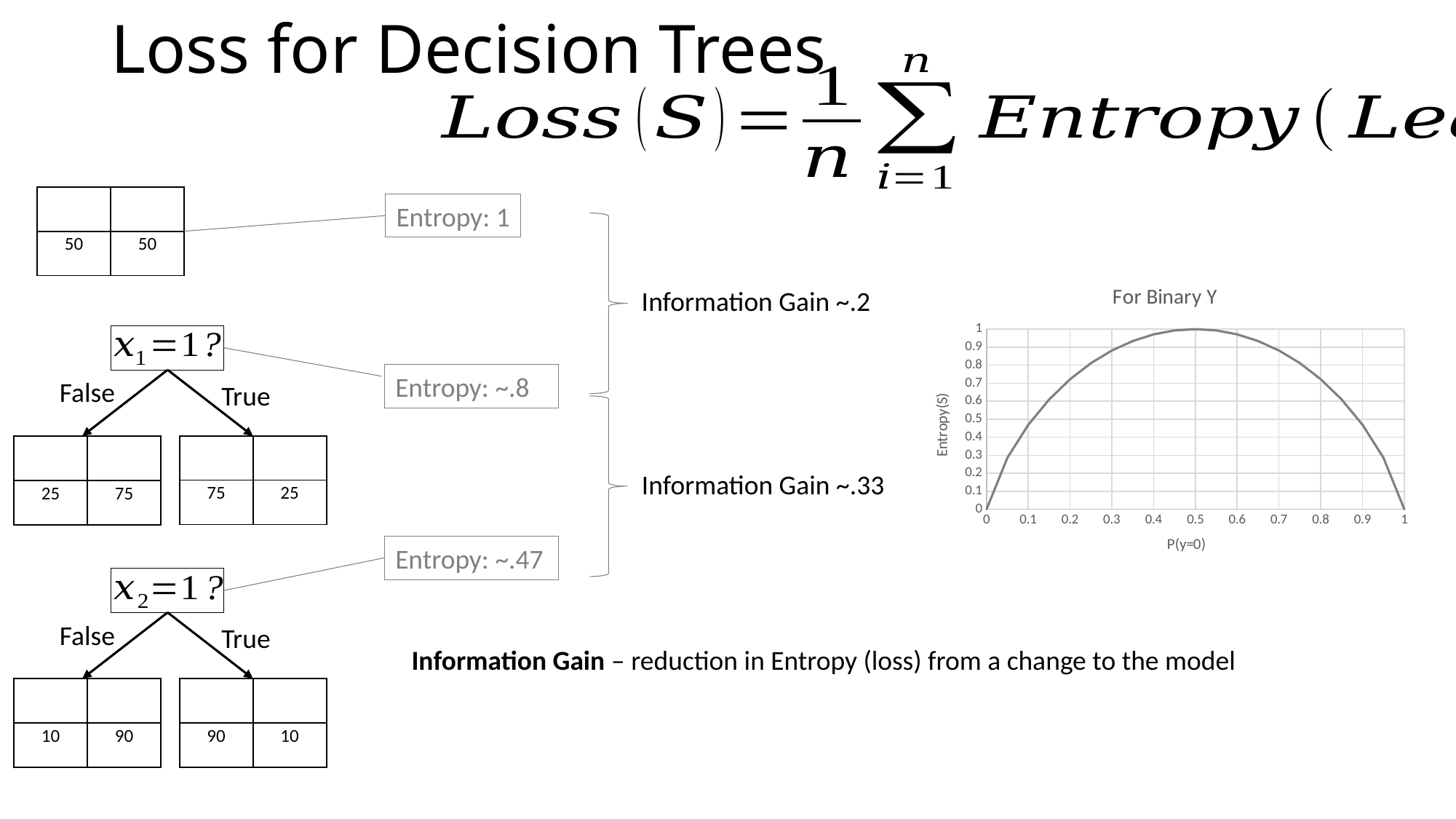
At which value of P(y=0) does the curve reach its highest Entropy(S)? 0.5 What is the value of Entropy(S) at P(y=0) = 0? 0 Which has the larger Entropy(S): P(y=0) = 0.1 or P(y=0) = 0.3? P(y=0) = 0.3 Does Entropy(S) rise or fall as P(y=0) increases from 0.5 to 1? fall What is the value of Entropy(S) at P(y=0) = 0.5? 1 What is the value of Entropy(S) at P(y=0) = 1? 0 What is the label of the x axis of the chart? P(y=0) Is the value of Entropy(S) at P(y=0) = 0.3 greater or less than 0.8? greater Is the value of Entropy(S) at P(y=0) = 0.2 greater or less than 0.5? greater What is the title of the chart on the slide? For Binary Y Is the value of Entropy(S) at P(y=0) = 0.8 greater or less than 0.5? greater What kind of chart is shown on the slide? line chart